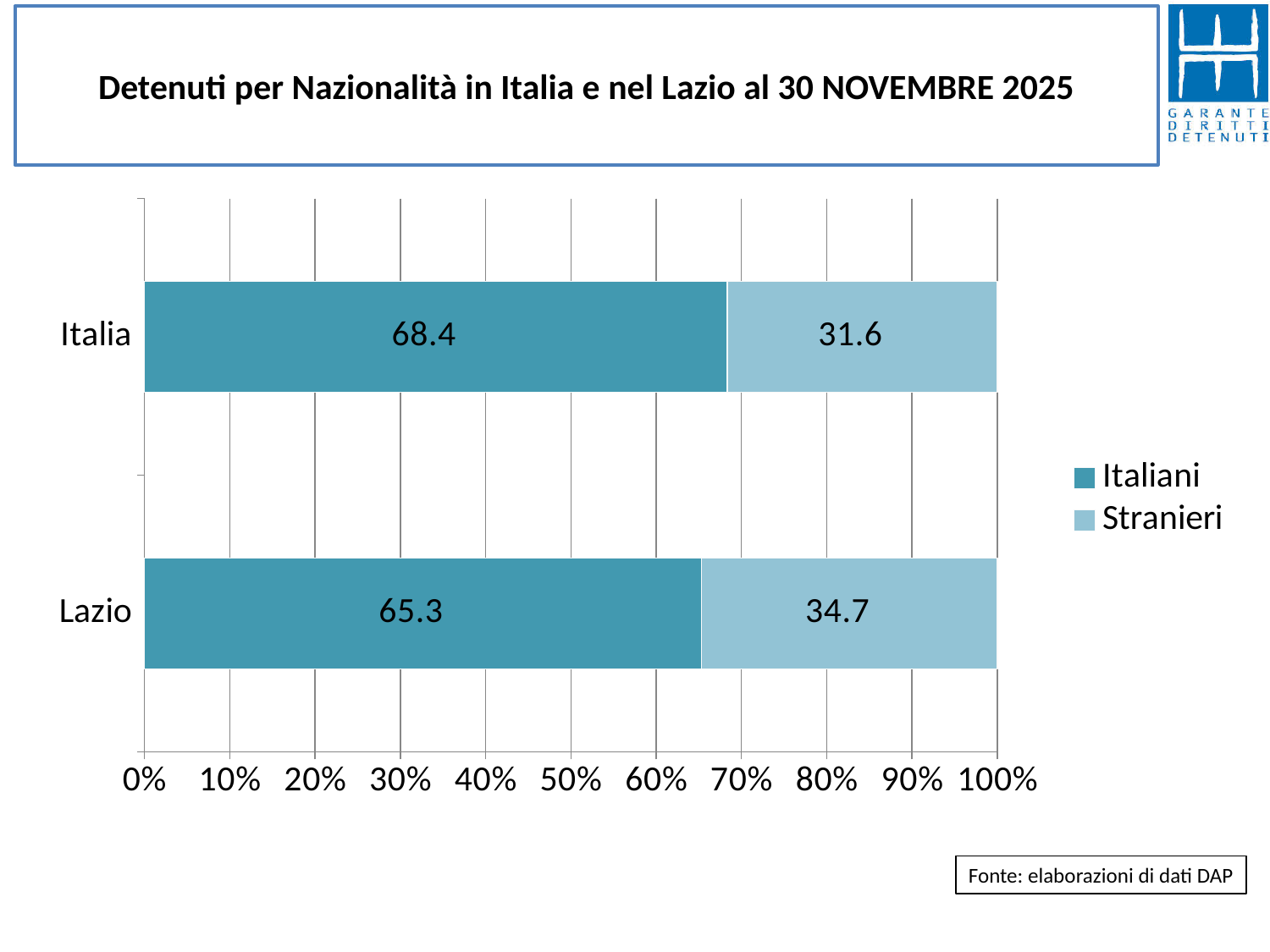
What is the value for Stranieri in Lazio? 34.7 What is the value for Italiani in Italia? 68.4 What is the value for Italiani in Lazio? 65.3 How many series does the legend list? 2 What is the difference between the Italiani values for Italia and Lazio? 3.1 How many categories are shown on the chart? 2 What is the value for Stranieri in Italia? 31.6 What is the total of the stacked bar for Lazio? 100 What is the difference between the Stranieri values for Lazio and Italia? 3.1 Which category has the higher Italiani value, Italia or Lazio? Italia Which category has the lower Stranieri value? Italia What kind of chart is shown on the slide? Stacked bar chart